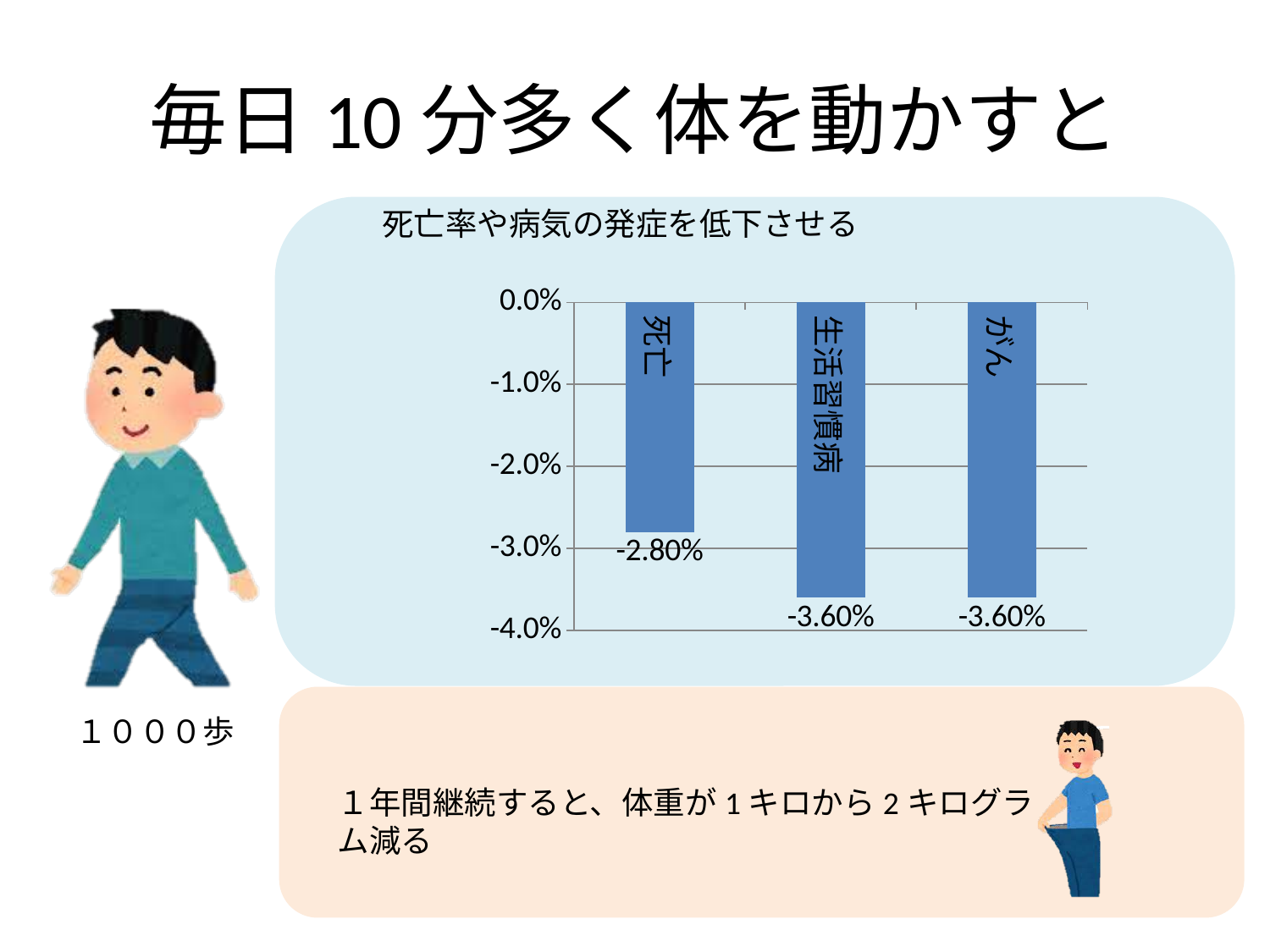
What is the lowest value shown on the vertical axis? -4.0% What is the value shown for 死亡? -2.80% What kind of chart is shown on the slide? bar chart Which category has the highest (least negative) value? 死亡 What is the value shown for 生活習慣病? -3.60% Is the value for 死亡 greater or less than -3.0%? greater Is the value for がん greater or less than -3.0%? less How many categories are plotted in the chart? 3 What is the difference between the values for 死亡 and 生活習慣病? 0.80% Do the values for 生活習慣病 and がん differ? No, both are -3.60% Which has the larger reduction, 死亡 or がん? がん What is the value shown for がん? -3.60%